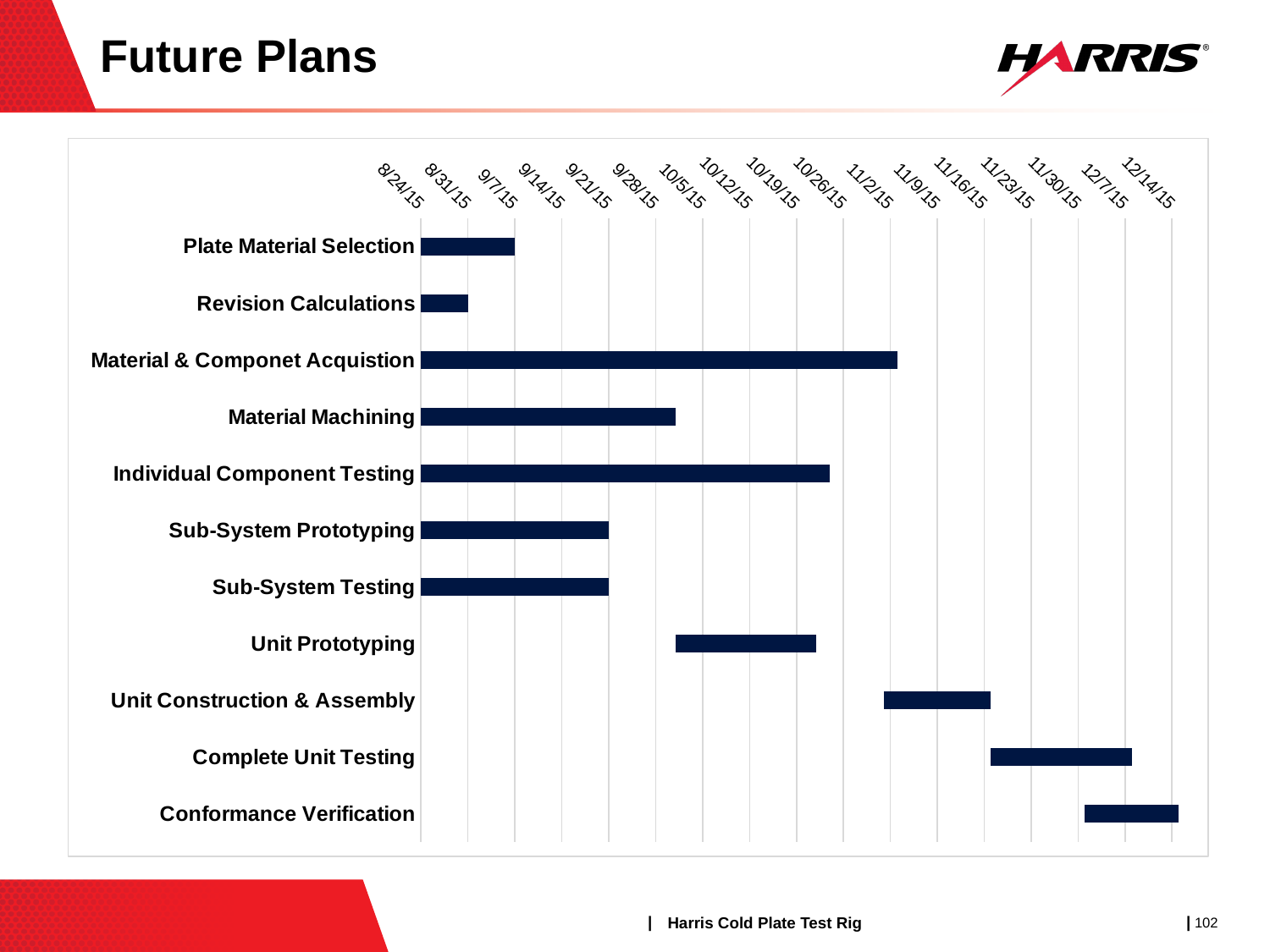
What is the title of the slide containing the chart? Future Plans What is the first date shown on the x axis? 8/24/15 Which task has the shortest bar on the chart? Revision Calculations On which date does the Plate Material Selection bar end? 9/7/15 Which bar is longer: Material Machining or Sub-System Prototyping? Material Machining Which task starts latest on the timeline? Conformance Verification How many tasks are listed on the chart? 11 What kind of chart is shown on the slide? Bar chart (Gantt chart) Which task has the longest bar on the chart? Material & Componet Acquistion